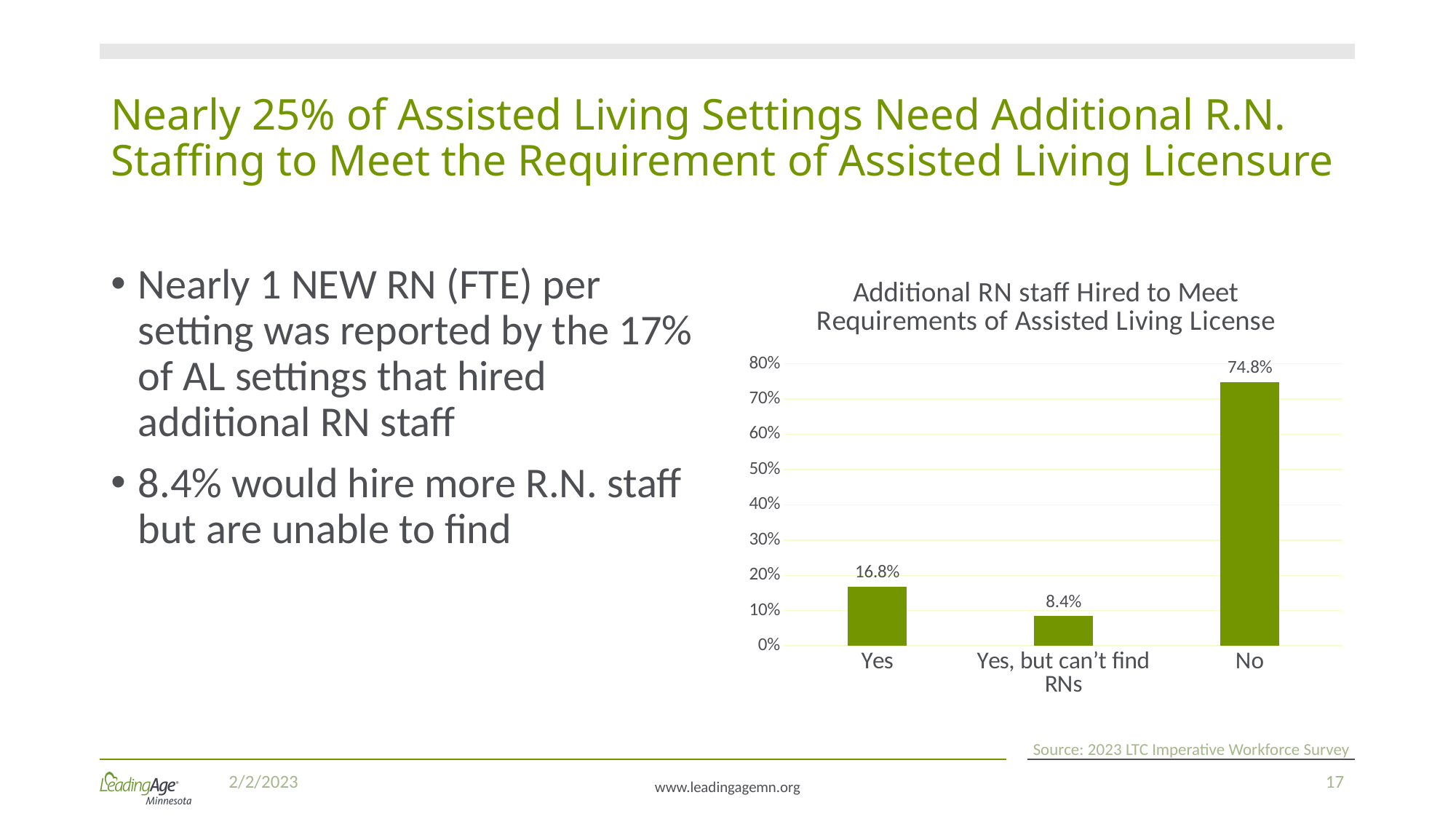
What is the title of the chart? Additional RN staff Hired to Meet Requirements of Assisted Living License How many categories are shown on the chart? 3 What kind of chart is shown on the slide? bar chart Is the value for "No" greater or less than 70%? greater Which is larger, the value for "Yes" or the value for "Yes, but can't find RNs"? Yes Which category has the highest value? No What is the value for the "No" category? 74.8% What is the value for the "Yes" category? 16.8% What is the value for the "Yes, but can't find RNs" category? 8.4% What is the difference between the values for "No" and "Yes"? 58.0% What is the difference between the values for "Yes" and "Yes, but can't find RNs"? 8.4% Which category has the lowest value? Yes, but can't find RNs